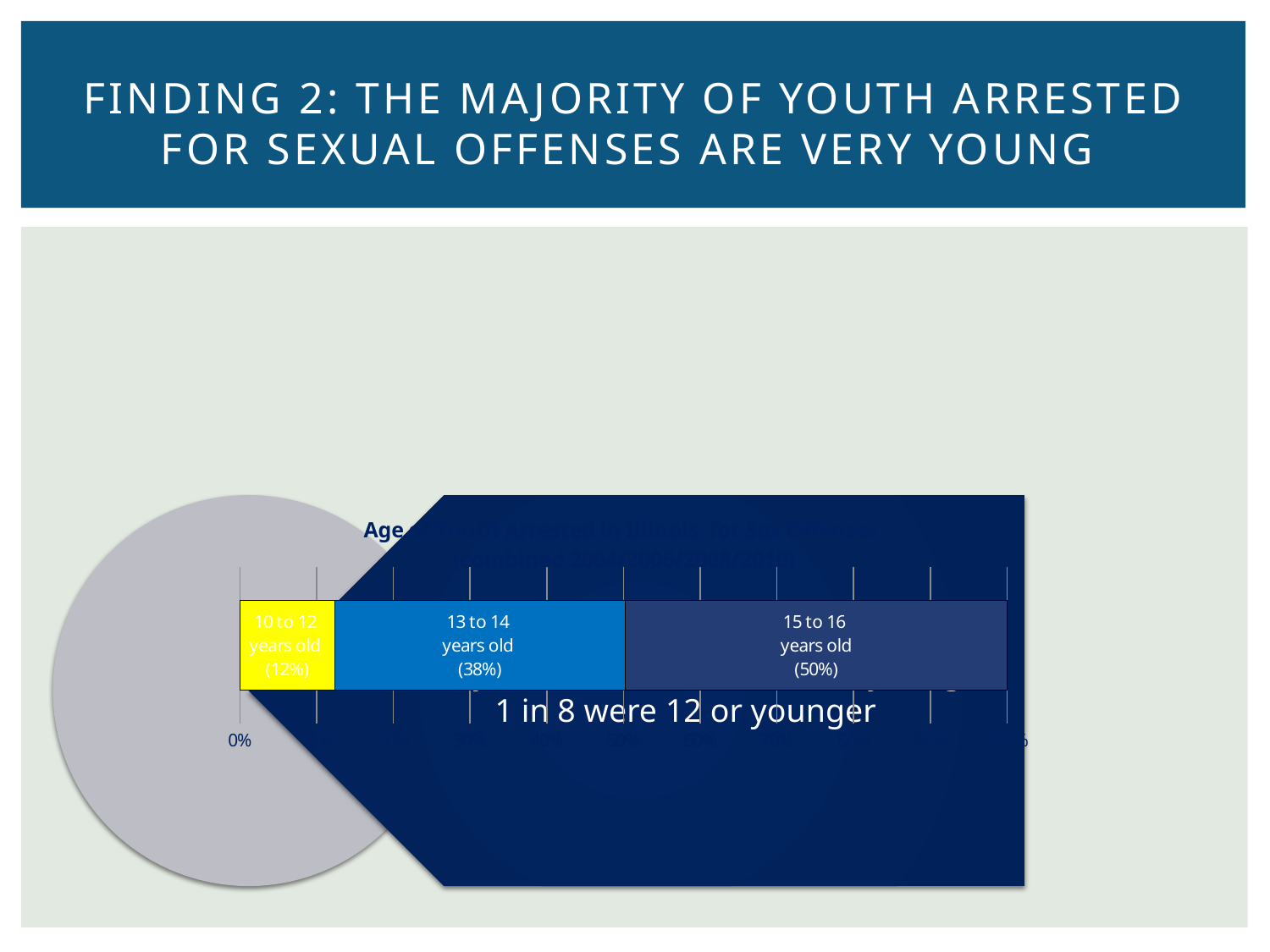
How many age groups are shown in the stacked bar? 3 What colour is the segment for the 10 to 12 years old group? Yellow What is the difference in percentage points between the 13 to 14 years old group and the 10 to 12 years old group? 26 What is the difference in percentage points between the 15 to 16 years old group and the 13 to 14 years old group? 12 What percentage of youth arrested were 13 to 14 years old? 38% What percentage of youth arrested were 10 to 12 years old? 12% Which is larger, the share for 13 to 14 years old or the share for 10 to 12 years old? 13 to 14 years old What percentage of youth arrested were 15 to 16 years old? 50% What kind of chart is shown on the slide? Stacked bar chart Which age group has the smallest share of youth arrested? 10 to 12 years old Which age group has the largest share of youth arrested? 15 to 16 years old What is the total of the three segments in the stacked bar? 100%